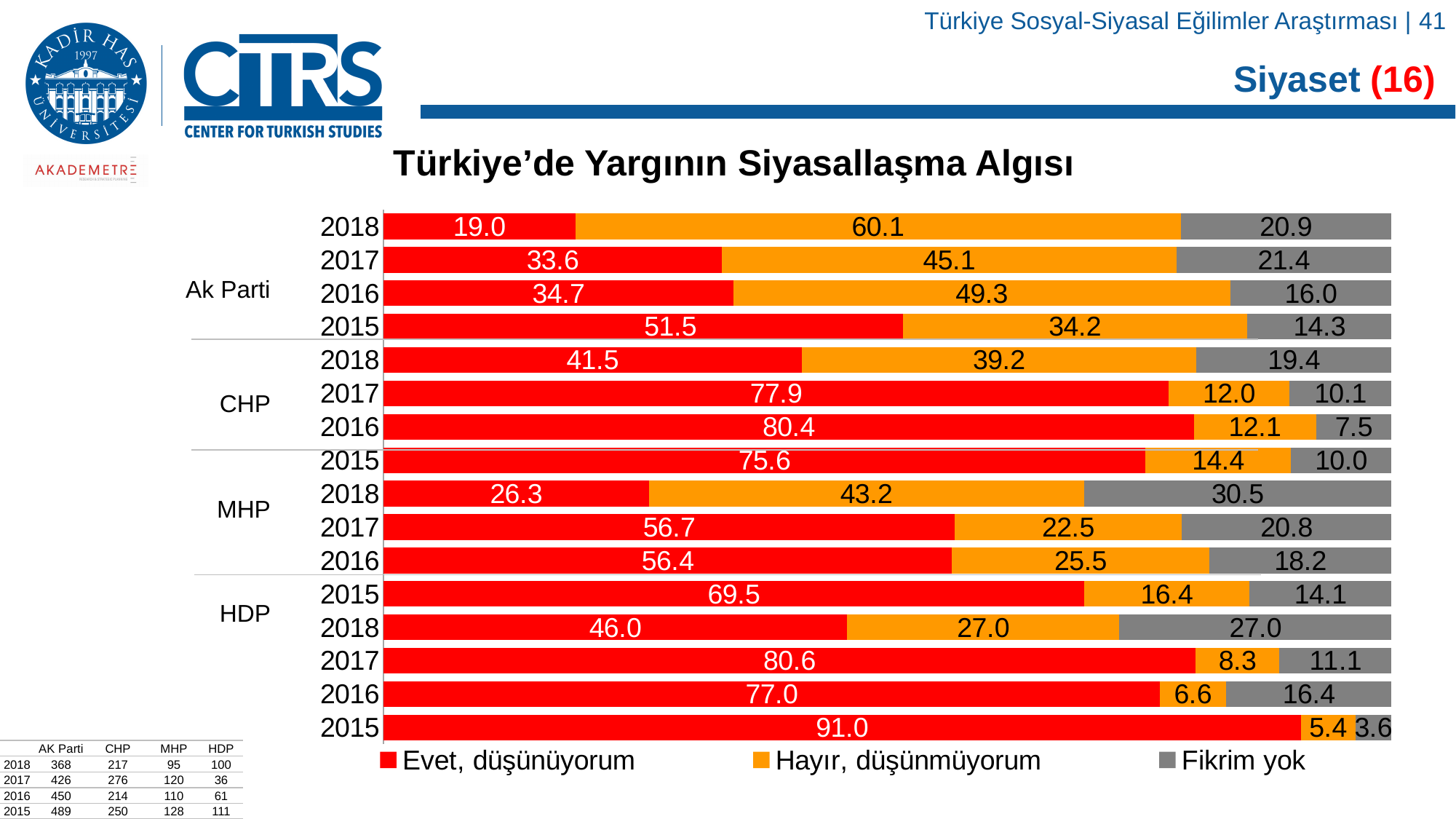
What is the title of the chart? Türkiye'de Yargının Siyasallaşma Algısı For the 2018 bar in the Ak Parti group, how much larger is the "Hayır, düşünmüyorum" value than the "Evet, düşünüyorum" value? 41.1 What is the "Evet, düşünüyorum" value for the 2018 bar in the Ak Parti group? 19.0 What is the "Evet, düşünüyorum" value for the 2016 bar in the CHP group? 80.4 In the Ak Parti group, which has the larger "Evet, düşünüyorum" value: 2017 or 2016? 2016 Within the Ak Parti group, which year has the highest "Evet, düşünüyorum" value? 2015 How many series does the legend list? 3 What kind of chart is shown on the slide? Stacked bar chart What is the total of the three segments in the 2018 bar of the Ak Parti group? 100.0 What is the "Fikrim yok" value for the 2015 bar in the Ak Parti group? 14.3 What is the "Evet, düşünüyorum" value for the bottom-most bar (2015) of the chart? 91.0 What is the "Hayır, düşünmüyorum" value for the 2018 bar in the Ak Parti group? 60.1